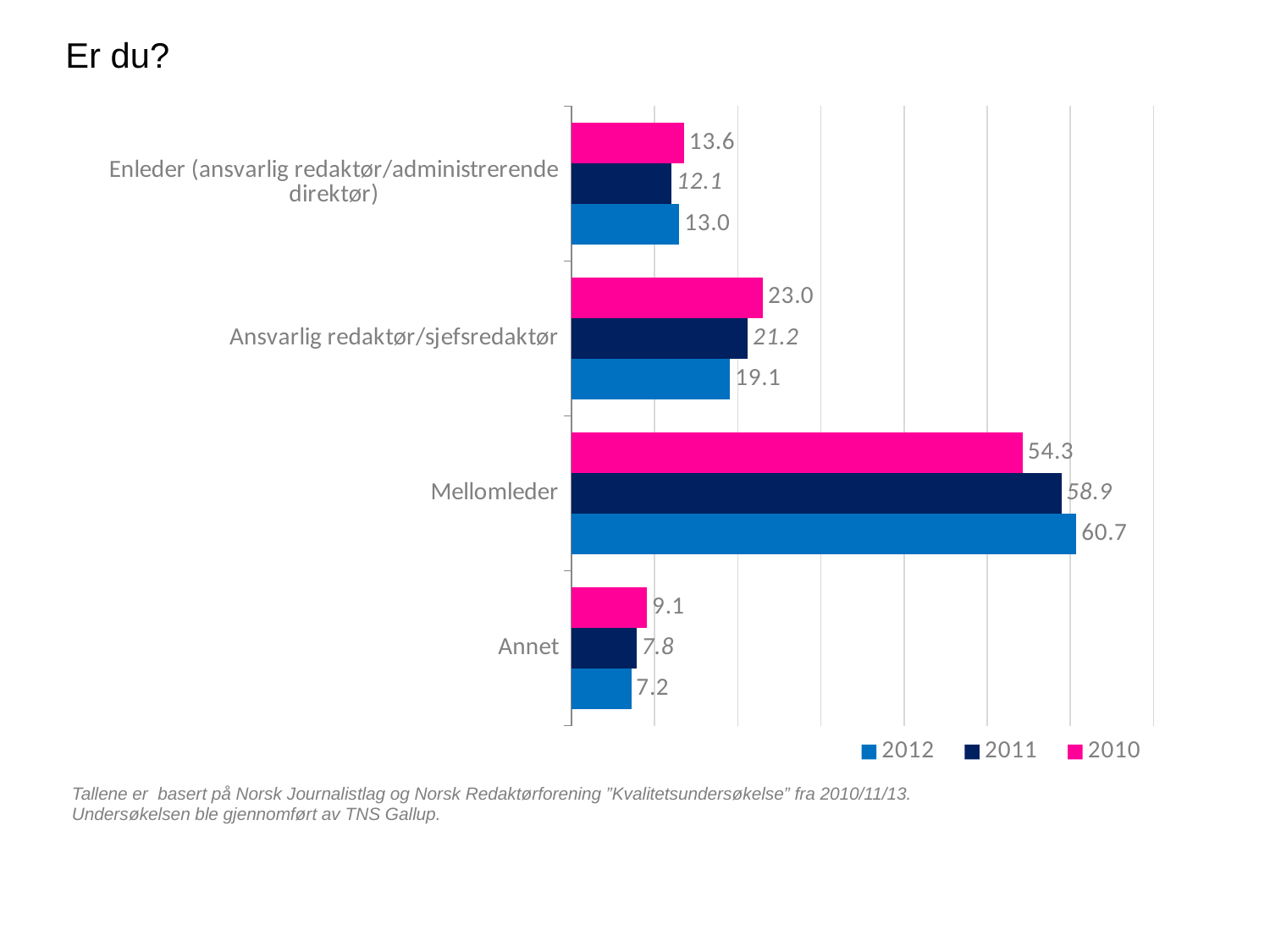
Which is larger for Ansvarlig redaktør/sjefsredaktør: the 2011 value or the 2012 value? 2011 Which category has the lowest value in 2012? Annet Which colour represents the 2010 series in the legend? Pink How many series does the legend list? 3 What is the difference between the 2012 and 2010 values for Mellomleder? 6.4 What is the value for Annet in 2011? 7.8 What kind of chart is shown on the slide? Bar chart What is the value for Ansvarlig redaktør/sjefsredaktør in 2010? 23.0 What is the value for Mellomleder in 2012? 60.7 What is the value for Enleder (ansvarlig redaktør/administrerende direktør) in 2012? 13.0 Which category has the highest value in 2010? Mellomleder How many categories are shown on the chart? 4